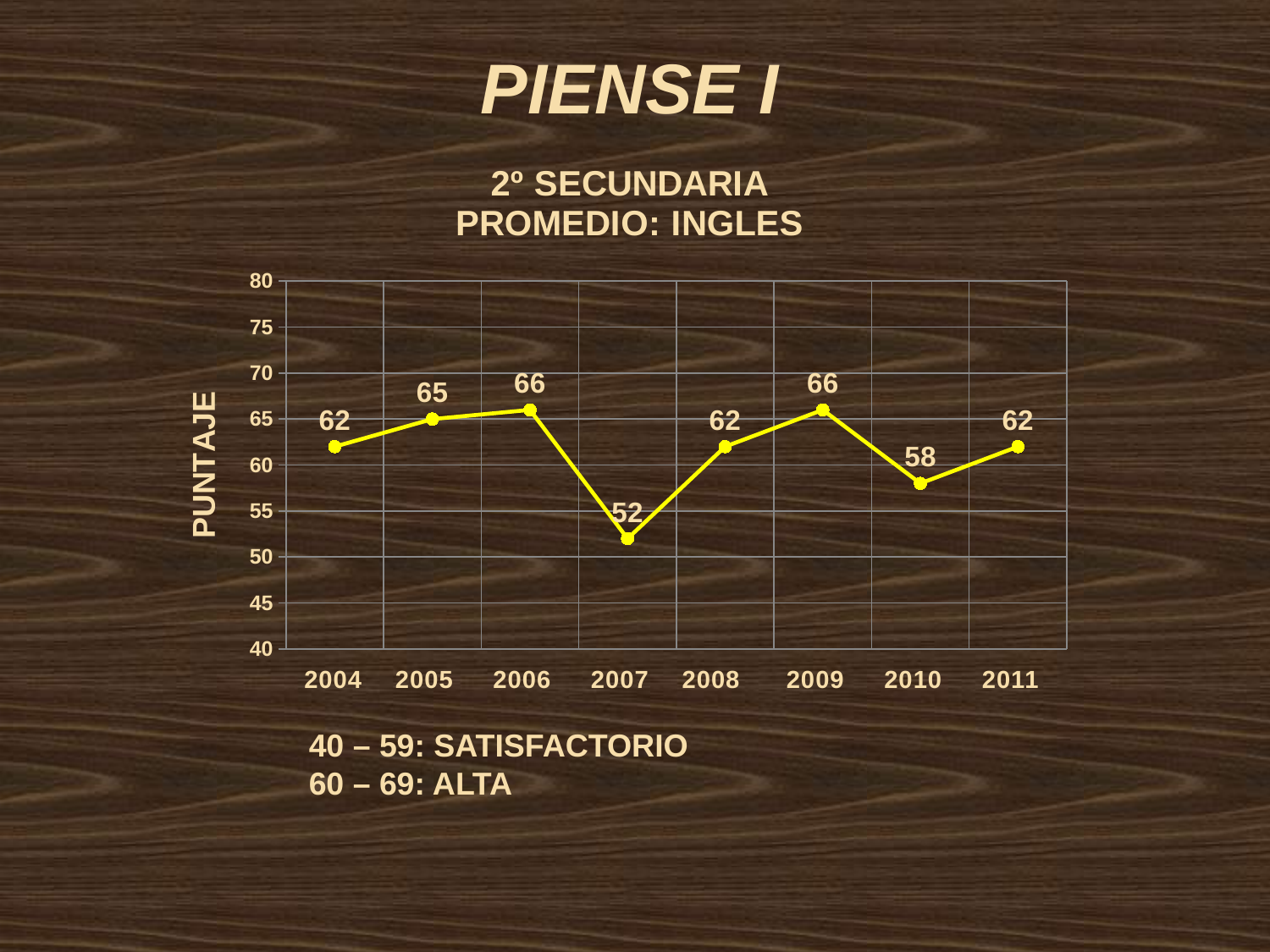
What is the label on the vertical axis? PUNTAJE Is the value for 2007 greater or less than 55? less What is the value for 2005? 65 What is the value for 2010? 58 What is the difference between the values for 2009 and 2010? 8 What is the difference between the values for 2006 and 2007? 14 Which is larger, the value for 2005 or the value for 2010? 2005 How many years are plotted on the chart? 8 What is the value for 2007? 52 Do the values rise or fall from 2004 to 2006? rise Which year has the lowest value? 2007 What kind of chart is shown on the slide? line chart